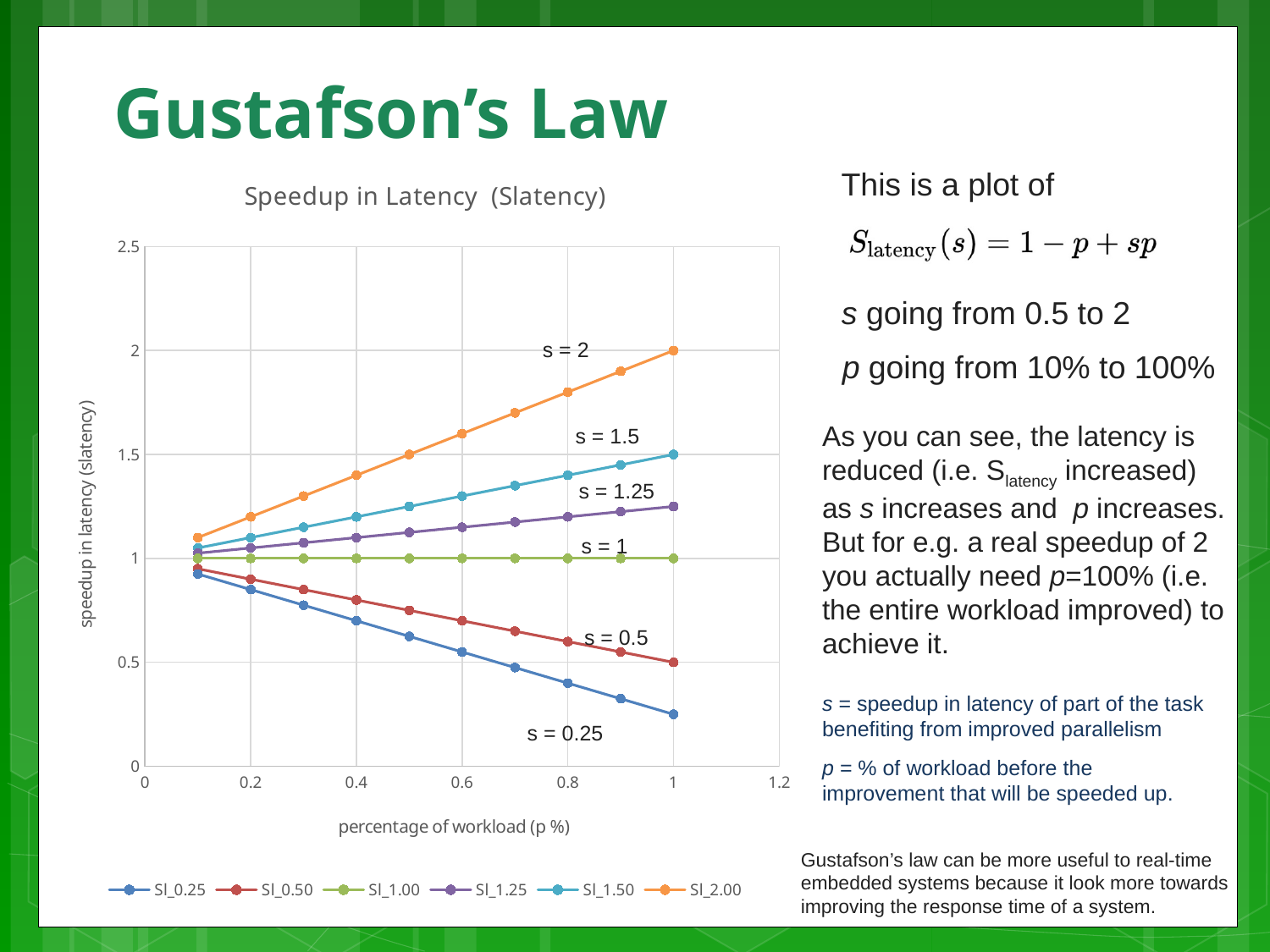
What is the title of the chart? Speedup in Latency (Slatency) What is the value of the s = 1 series at p = 0.6? 1 What is the label of the x axis? percentage of workload (p %) What kind of chart is shown on the slide? line chart How many series does the legend list? 6 What is the value of the s = 1.5 series at p = 1? 1.5 Is the value of the s = 0.25 series at p = 1 greater or less than 0.5? less What is the value of the s = 0.5 series at p = 1? 0.5 Which series has the highest value at p = 1? s = 2 (Sl_2.00) Which series has the lowest value at p = 1? s = 0.25 (Sl_0.25) What is the value of the s = 2 series at p = 1? 2 Does the s = 0.25 series rise or fall as p increases? fall